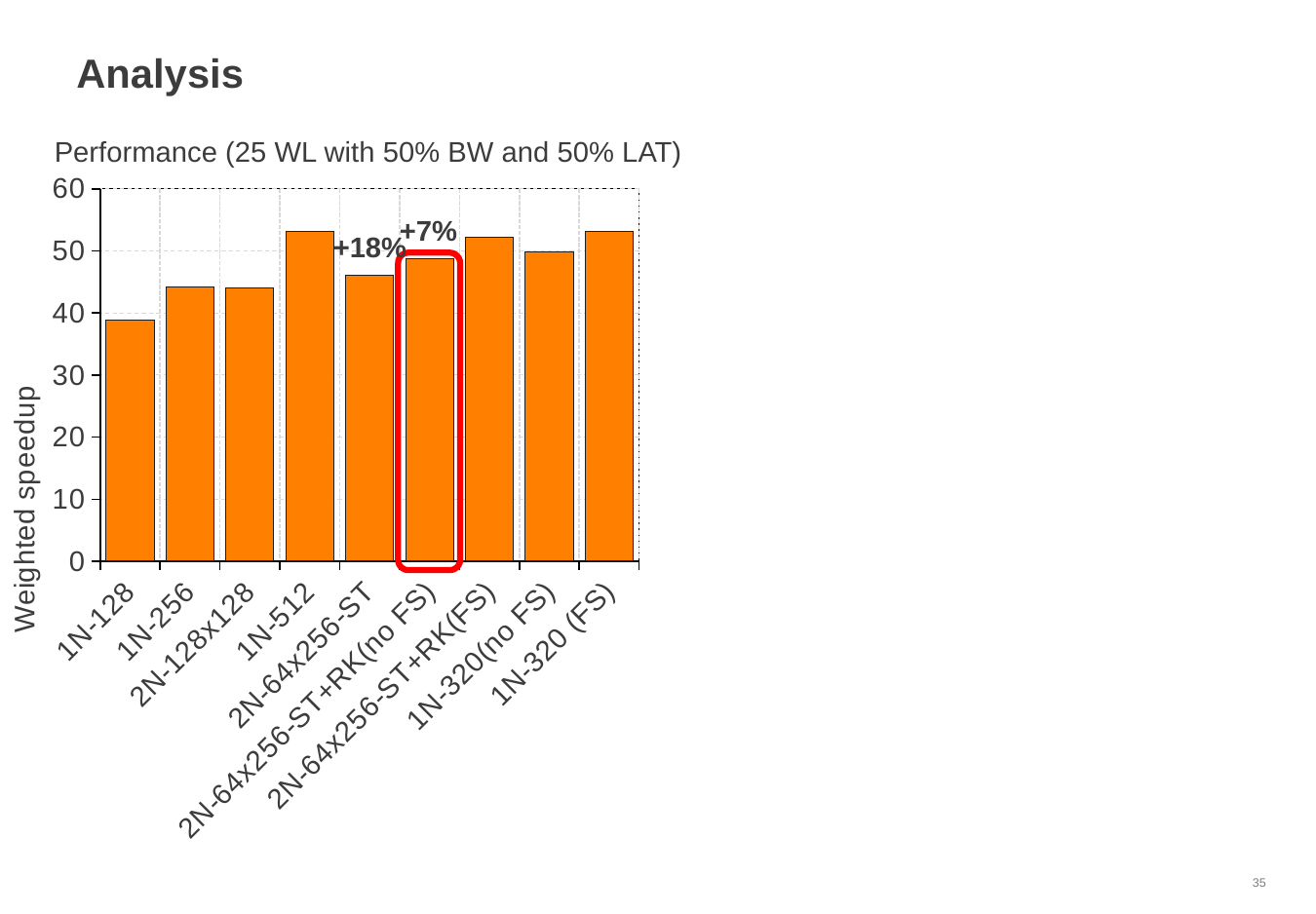
What kind of chart is shown on the slide? bar chart Is the weighted speedup for 2N-64x256-ST greater or less than 50? less What is the label of the y axis of the chart? Weighted speedup Is the weighted speedup for 1N-256 greater or less than 40? greater Which configuration has the lowest weighted speedup? 1N-128 Is the weighted speedup for 1N-128 greater or less than 40? less How many configurations (bars) are plotted in the chart? 9 Which has a higher weighted speedup, 2N-64x256-ST+RK(FS) or 2N-64x256-ST? 2N-64x256-ST+RK(FS) Which has a higher weighted speedup, 1N-512 or 1N-128? 1N-512 Which bar is highlighted with a red box in the chart? 2N-64x256-ST+RK(no FS)